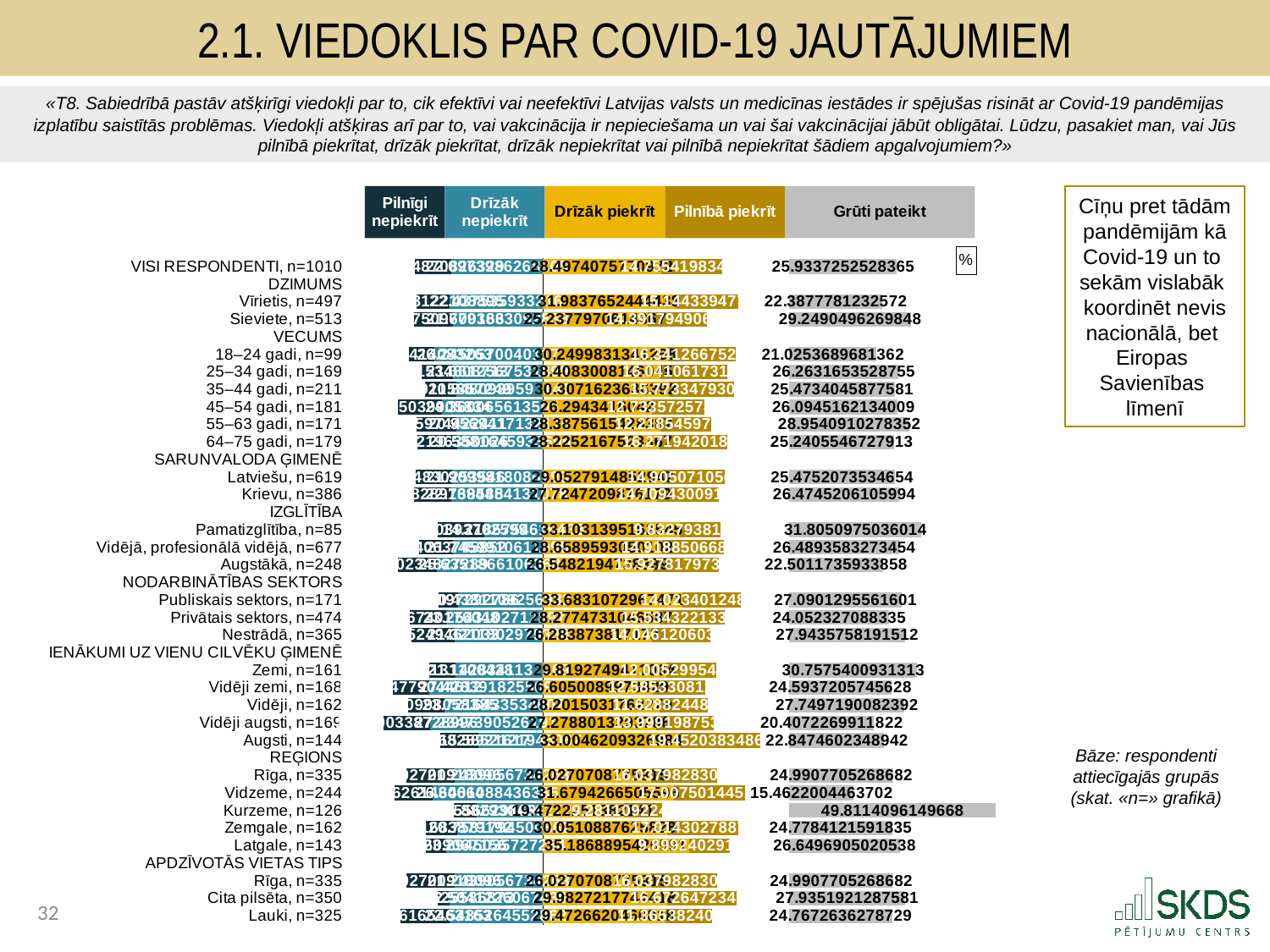
What is the title of the slide? 2.1. VIEDOKLIS PAR COVID-19 JAUTĀJUMIEM What is the 'Grūti pateikt' value for Vidzeme, n=244? 15.4622004463702 Among the REĢIONS groups, which has the highest 'Grūti pateikt' value? Kurzeme, n=126 What kind of chart is shown on the slide? bar chart What is the 'Grūti pateikt' value for Pamatizglītība, n=85? 31.8050975036014 How many age groups are listed under VECUMS? 6 Among the REĢIONS groups, which has the lowest 'Grūti pateikt' value? Vidzeme, n=244 What is the 'Grūti pateikt' value for Kurzeme, n=126? 49.8114096149668 What is the difference between the 'Grūti pateikt' values for Sieviete, n=513 and Vīrietis, n=497? 6.8612715037276 How many series does the legend list? 5 What is the 'Grūti pateikt' value for VISI RESPONDENTI, n=1010? 25.9337252528365 Which has the larger 'Grūti pateikt' value: Vīrietis, n=497 or Sieviete, n=513? Sieviete, n=513